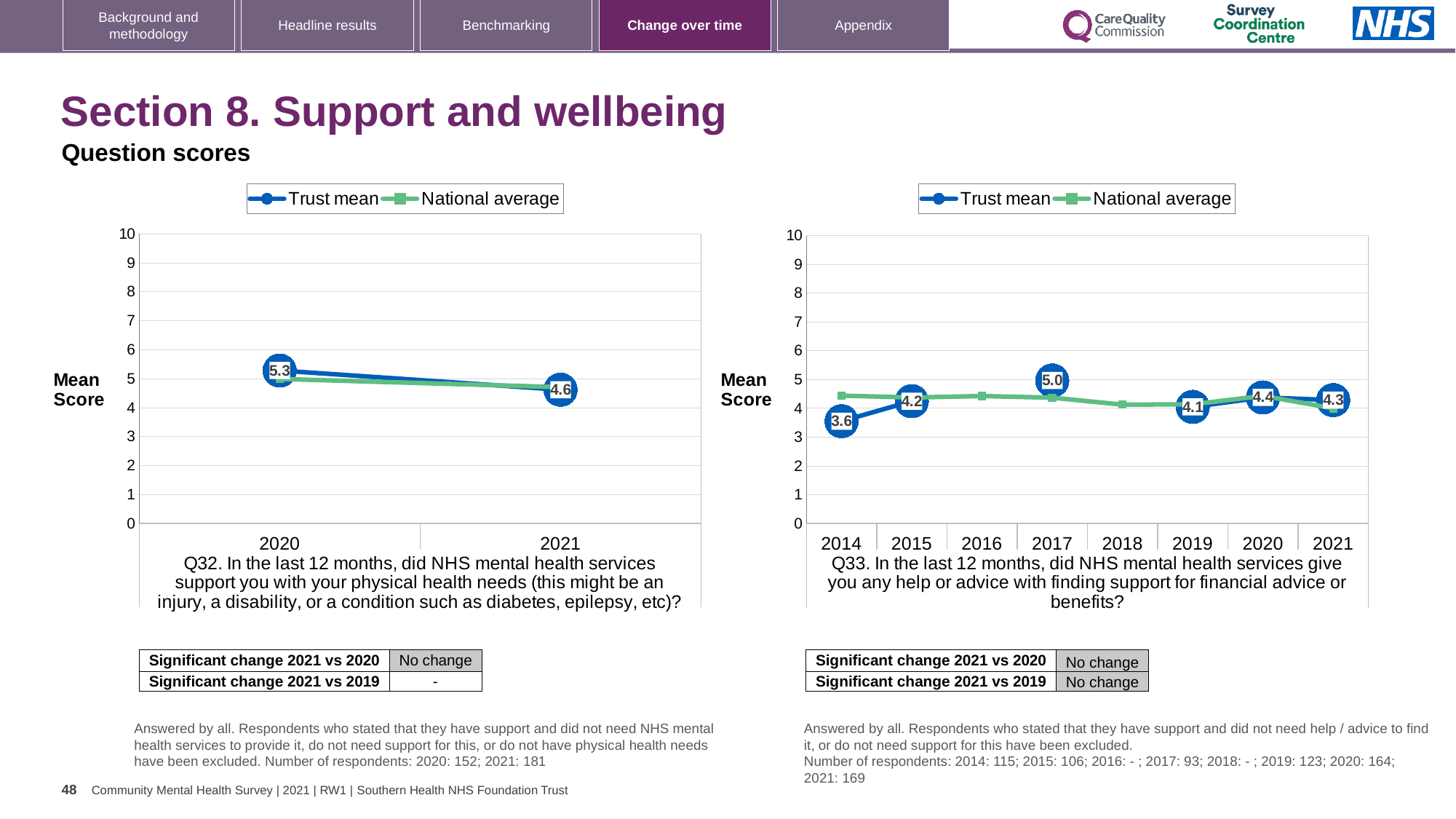
In the Q32 chart on the left, what is the Trust mean for 2021? 4.6 How many series does the legend of the Q33 chart on the right list? 2 In the Q33 chart on the right, which year has the lowest Trust mean? 2014 In the Q33 chart on the right, what is the Trust mean for 2014? 3.6 In the Q33 chart on the right, what is the Trust mean for 2021? 4.3 In the Q33 chart on the right, what is the Trust mean for 2017? 5.0 In the Q32 chart on the left, does the Trust mean rise or fall from 2020 to 2021? fall In the Q32 chart on the left, what is the difference between the Trust mean for 2020 and 2021? 0.7 In the Q32 chart on the left, what is the Trust mean for 2020? 5.3 In the Q33 chart on the right, is the Trust mean for 2020 or 2019 larger? 2020 What kind of chart is the Q32 chart on the left? line chart In the Q33 chart on the right, which year has the highest Trust mean? 2017